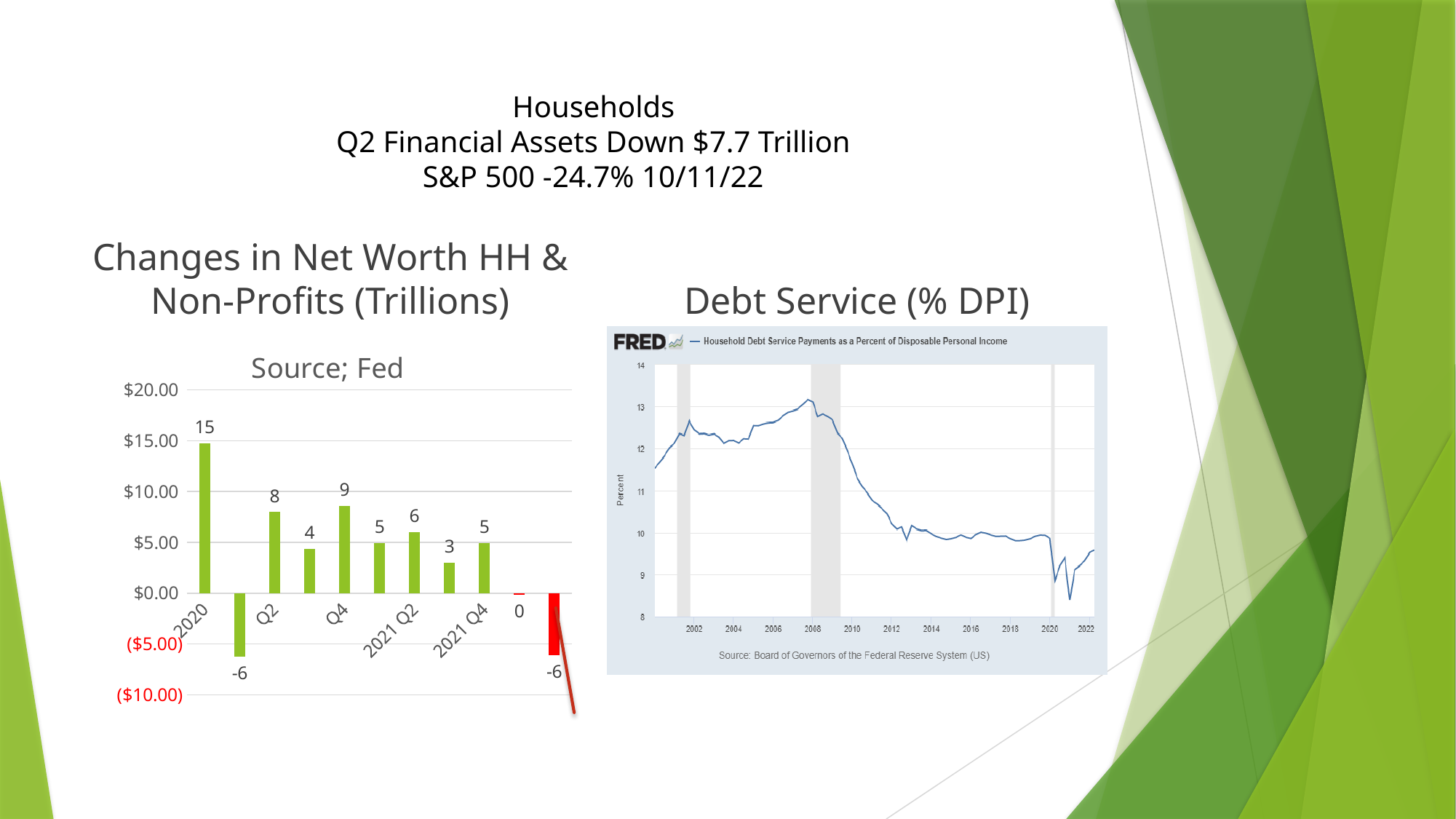
In the 'Changes in Net Worth HH & Non-Profits (Trillions)' bar chart, what is the value for 2021 Q4? 5 In the 'Changes in Net Worth HH & Non-Profits (Trillions)' bar chart, what is the difference between the values for Q4 and Q2? 1 In the 'Changes in Net Worth HH & Non-Profits (Trillions)' bar chart, what is the value for 2021 Q2? 6 What kind of chart is the 'Debt Service (% DPI)' chart? line chart In the 'Debt Service (% DPI)' chart, does the value rise or fall between 2008 and 2012? fall What kind of chart is the 'Changes in Net Worth HH & Non-Profits (Trillions)' chart? bar chart In the 'Changes in Net Worth HH & Non-Profits (Trillions)' bar chart, what is the value for Q4? 9 In the 'Changes in Net Worth HH & Non-Profits (Trillions)' bar chart, which is larger, the value for 2021 Q2 or the value for 2021 Q4? 2021 Q2 How many bars are plotted in the 'Changes in Net Worth HH & Non-Profits (Trillions)' bar chart? 11 In the 'Changes in Net Worth HH & Non-Profits (Trillions)' bar chart, what is the value for 2020? 15 In the 'Debt Service (% DPI)' chart, is the value in 2012 greater or less than 11? less In the 'Changes in Net Worth HH & Non-Profits (Trillions)' bar chart, which category has the highest value? 2020